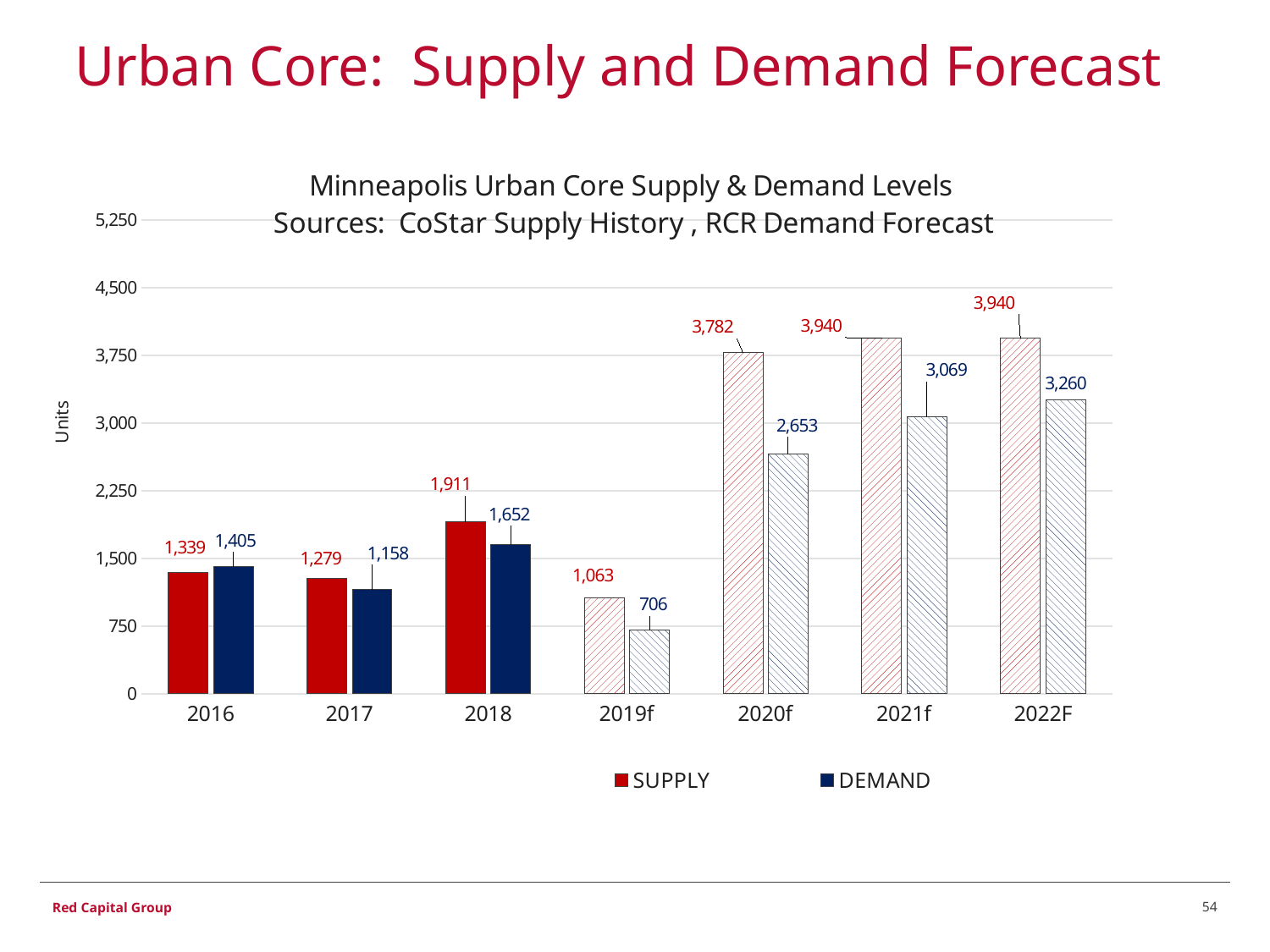
What is the label on the vertical axis? Units Which year has the highest DEMAND value? 2022F What is the difference between SUPPLY and DEMAND in 2020f? 1,129 Is the SUPPLY value for 2019f greater or less than 750? greater Which is larger in 2016, SUPPLY or DEMAND? DEMAND What is the DEMAND value for 2019f? 706 Which year has the lowest DEMAND value? 2019f How many years are shown on the x axis? 7 What is the DEMAND value for 2021f? 3,069 What kind of chart is shown on the slide? Bar chart How many series does the legend list? 2 What is the SUPPLY value for 2018? 1,911